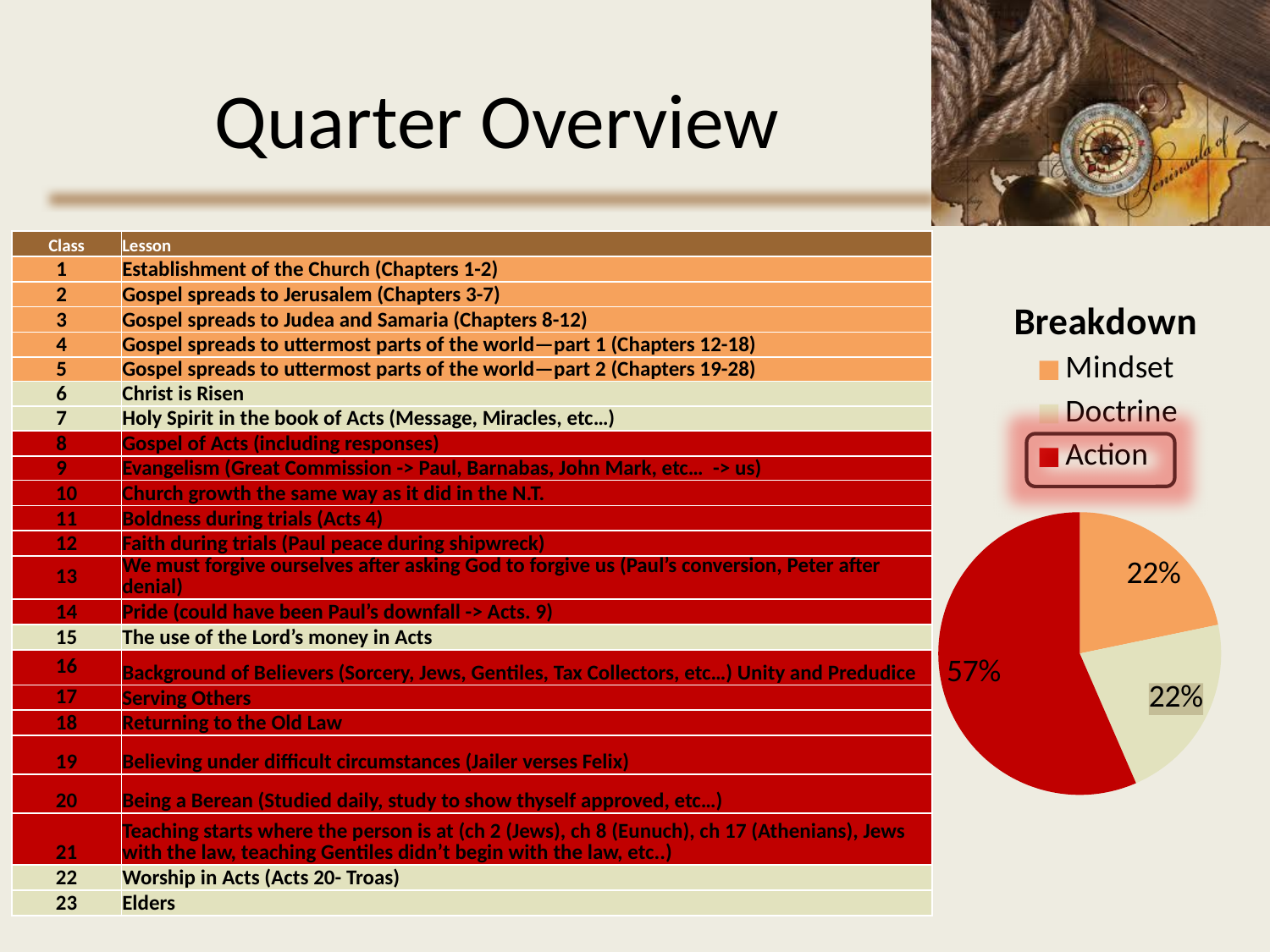
What colour represents Action in the Breakdown pie chart? red In the Breakdown pie chart, what share is labelled for the Action slice? 57% What is the title of the pie chart on the slide? Breakdown How many slices does the Breakdown pie chart have? 3 In the Breakdown pie chart, what share is labelled for the Mindset slice? 22% How many entries does the legend of the Breakdown pie chart list? 3 Which category has the largest slice in the Breakdown pie chart? Action In the Breakdown pie chart, which is larger: the Action slice or the Mindset slice? Action In the Breakdown pie chart, what is the difference between the Action share and the Doctrine share? 35% In the Breakdown pie chart, what share is labelled for the Doctrine slice? 22% What kind of chart is shown under the title "Breakdown"? pie chart